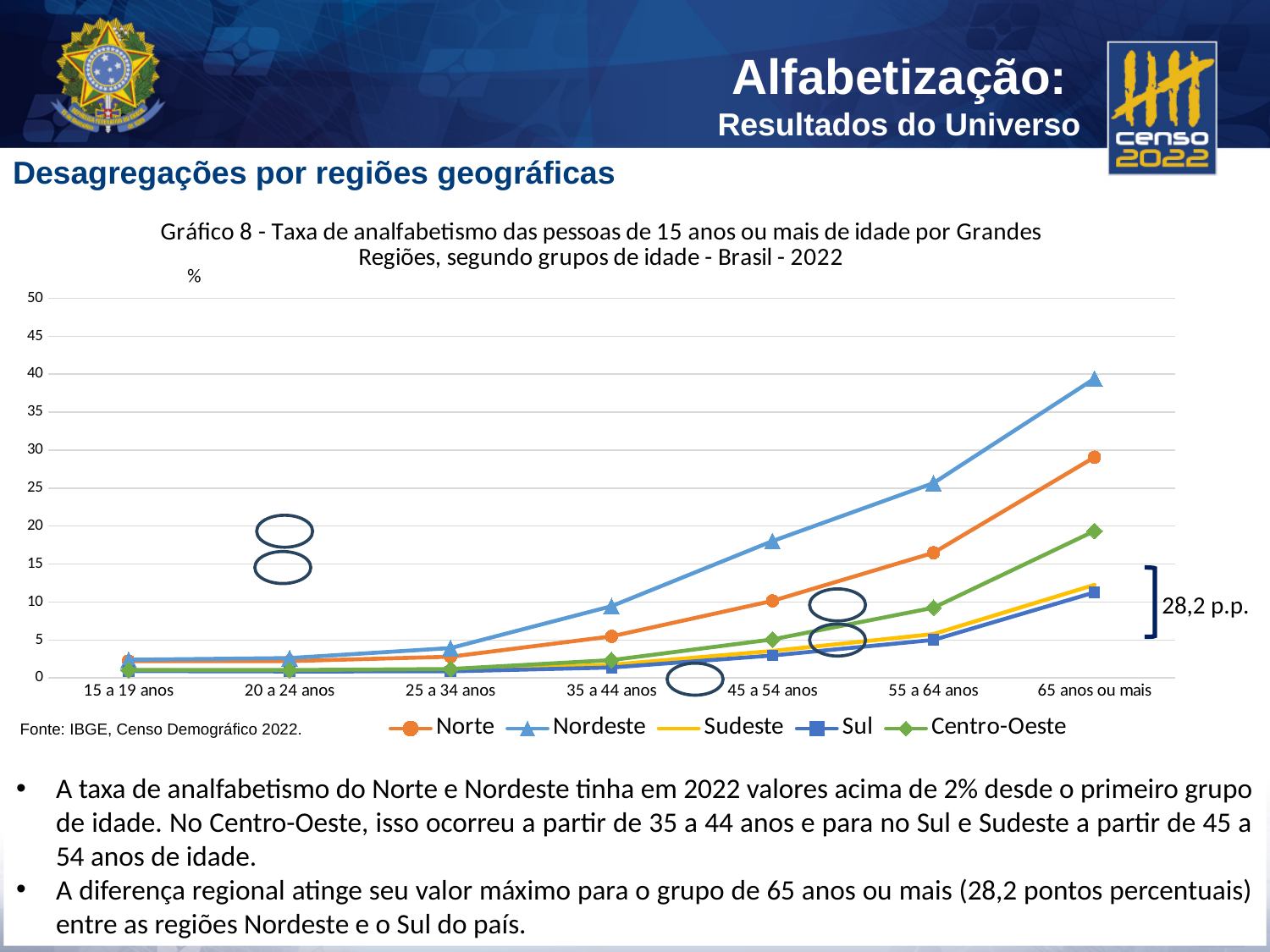
Is the value for Norte at '65 anos ou mais' greater or less than 25? greater Which region has the highest illiteracy rate for the group '65 anos ou mais'? Nordeste What unit is shown at the top of the y axis of Gráfico 8? % Which is larger at '45 a 54 anos': the value for Nordeste or the value for Norte? Nordeste Is the value for Centro-Oeste at '65 anos ou mais' greater or less than 15? greater Do the values for Nordeste rise or fall as the age groups increase along the x axis? rise Is the value for Nordeste at '55 a 64 anos' greater or less than 30? less What kind of chart is Gráfico 8? line chart How many age groups are shown on the x axis of Gráfico 8? 7 How many series does the legend of Gráfico 8 list? 5 What is the difference in percentage points between Nordeste and Sul for the group '65 anos ou mais', as annotated on the chart? 28,2 p.p.